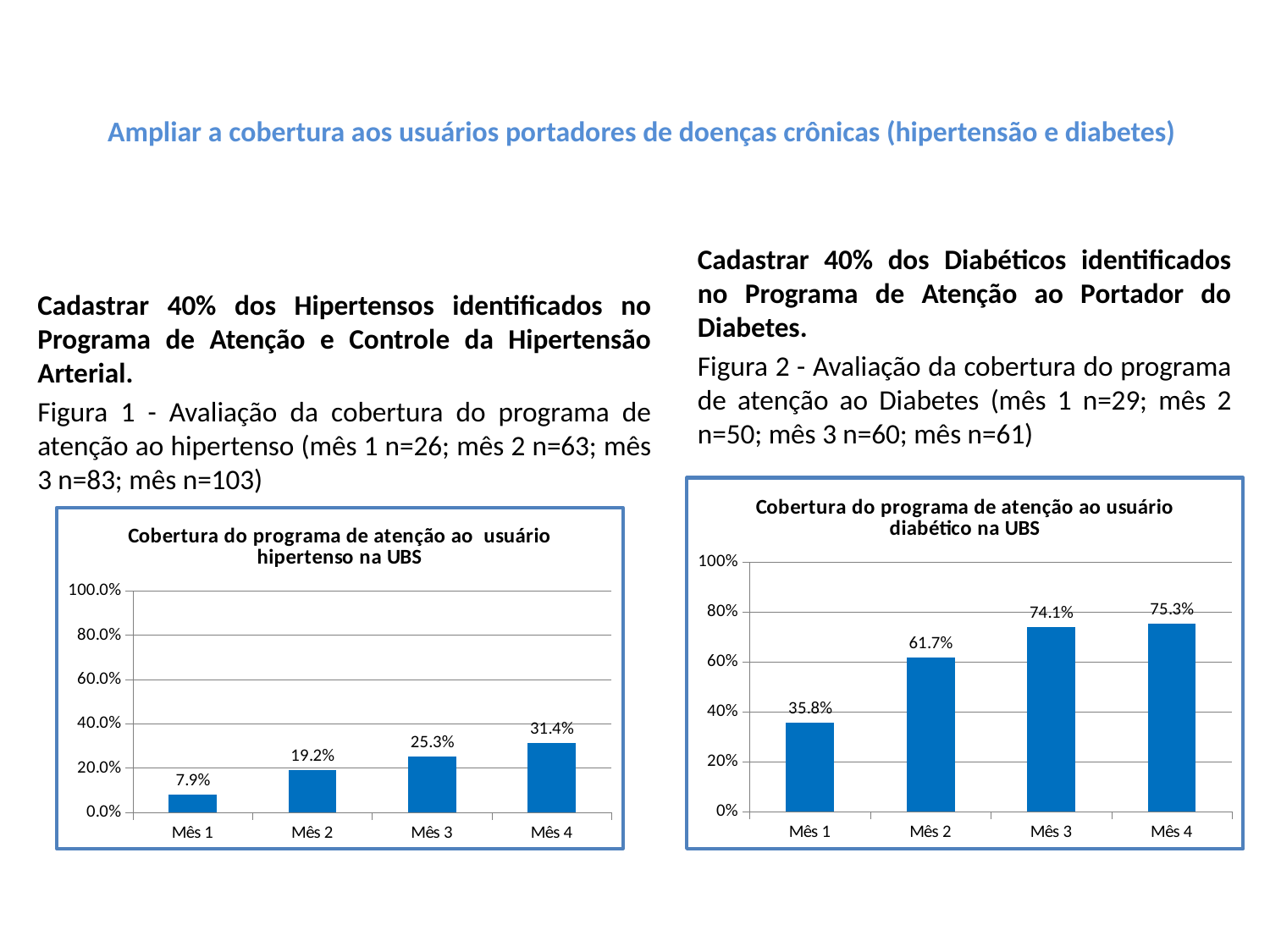
In the chart 'Cobertura do programa de atenção ao usuário diabético na UBS', what is the value for Mês 2? 61.7% In the chart 'Cobertura do programa de atenção ao usuário hipertenso na UBS', which month has the lowest value? Mês 1 In the chart 'Cobertura do programa de atenção ao usuário diabético na UBS', what is the value for Mês 3? 74.1% In the chart 'Cobertura do programa de atenção ao usuário diabético na UBS', which month has the highest value? Mês 4 In the chart 'Cobertura do programa de atenção ao usuário hipertenso na UBS', what is the value for Mês 1? 7.9% What kind of chart is 'Cobertura do programa de atenção ao usuário diabético na UBS'? bar chart In the chart 'Cobertura do programa de atenção ao usuário diabético na UBS', which is larger, the value for Mês 1 or the value for Mês 2? Mês 2 In the chart 'Cobertura do programa de atenção ao usuário hipertenso na UBS', what is the value for Mês 4? 31.4% In the chart 'Cobertura do programa de atenção ao usuário diabético na UBS', what is the difference between Mês 2 and Mês 1? 25.9% In the chart 'Cobertura do programa de atenção ao usuário hipertenso na UBS', what is the difference between Mês 4 and Mês 3? 6.1% In the chart 'Cobertura do programa de atenção ao usuário hipertenso na UBS', how many months are plotted? 4 In the chart 'Cobertura do programa de atenção ao usuário hipertenso na UBS', do the values rise or fall from Mês 1 to Mês 4? rise